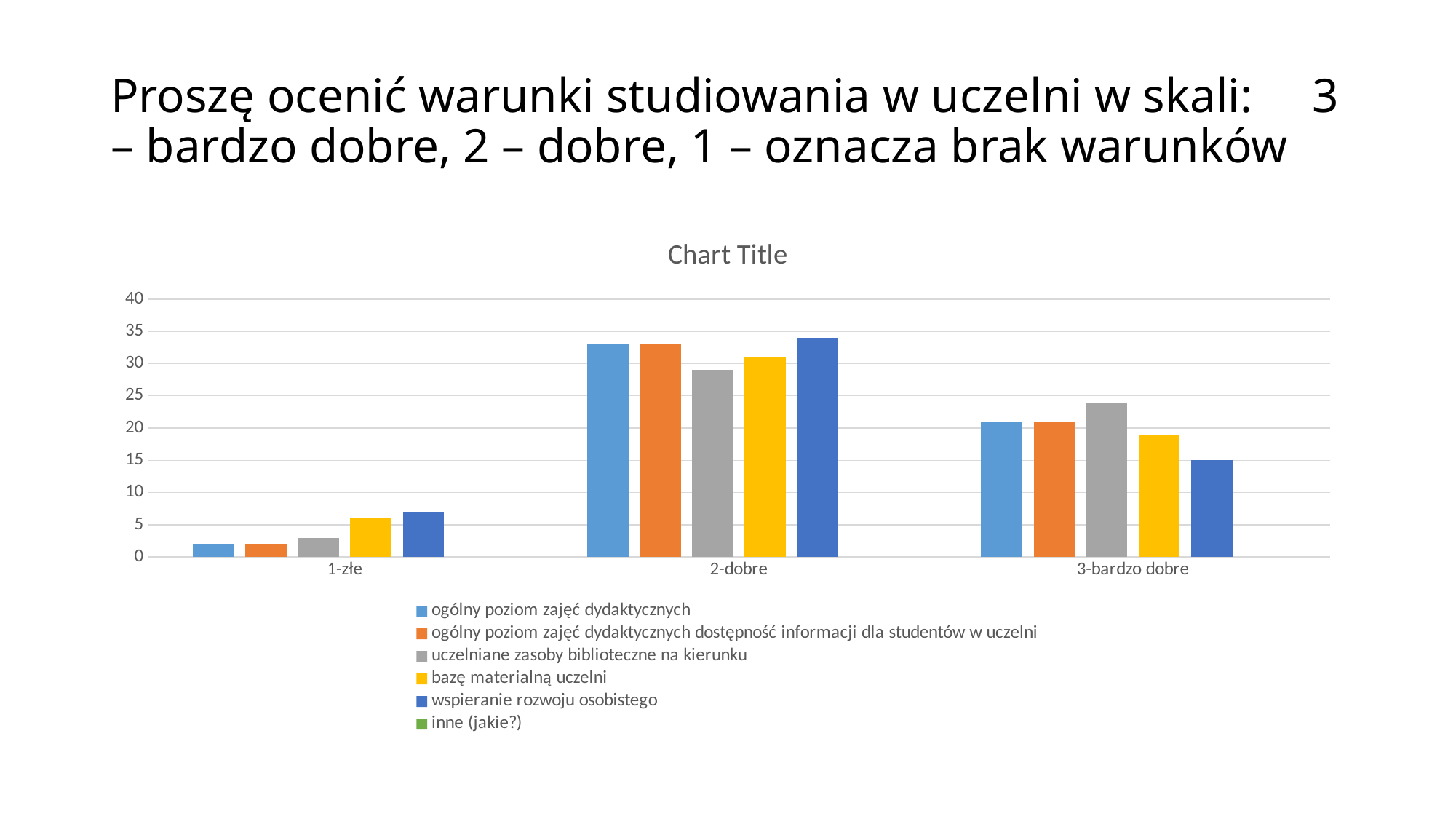
What kind of chart is shown on the slide? bar chart What is the title shown above the chart? Chart Title Which series has the lowest bar in the '3-bardzo dobre' category? wspieranie rozwoju osobistego Is the value for 'bazę materialną uczelni' in the '1-złe' category greater or less than 10? less Is the value for 'uczelniane zasoby biblioteczne na kierunku' in the '3-bardzo dobre' category greater or less than 20? greater For 'bazę materialną uczelni', which category has the larger value: '2-dobre' or '3-bardzo dobre'? 2-dobre Is the value for 'wspieranie rozwoju osobistego' in the '3-bardzo dobre' category greater or less than 20? less How many categories are shown on the x axis of the chart? 3 How many series does the chart's legend list? 6 Which series has the highest bar in the '3-bardzo dobre' category? uczelniane zasoby biblioteczne na kierunku